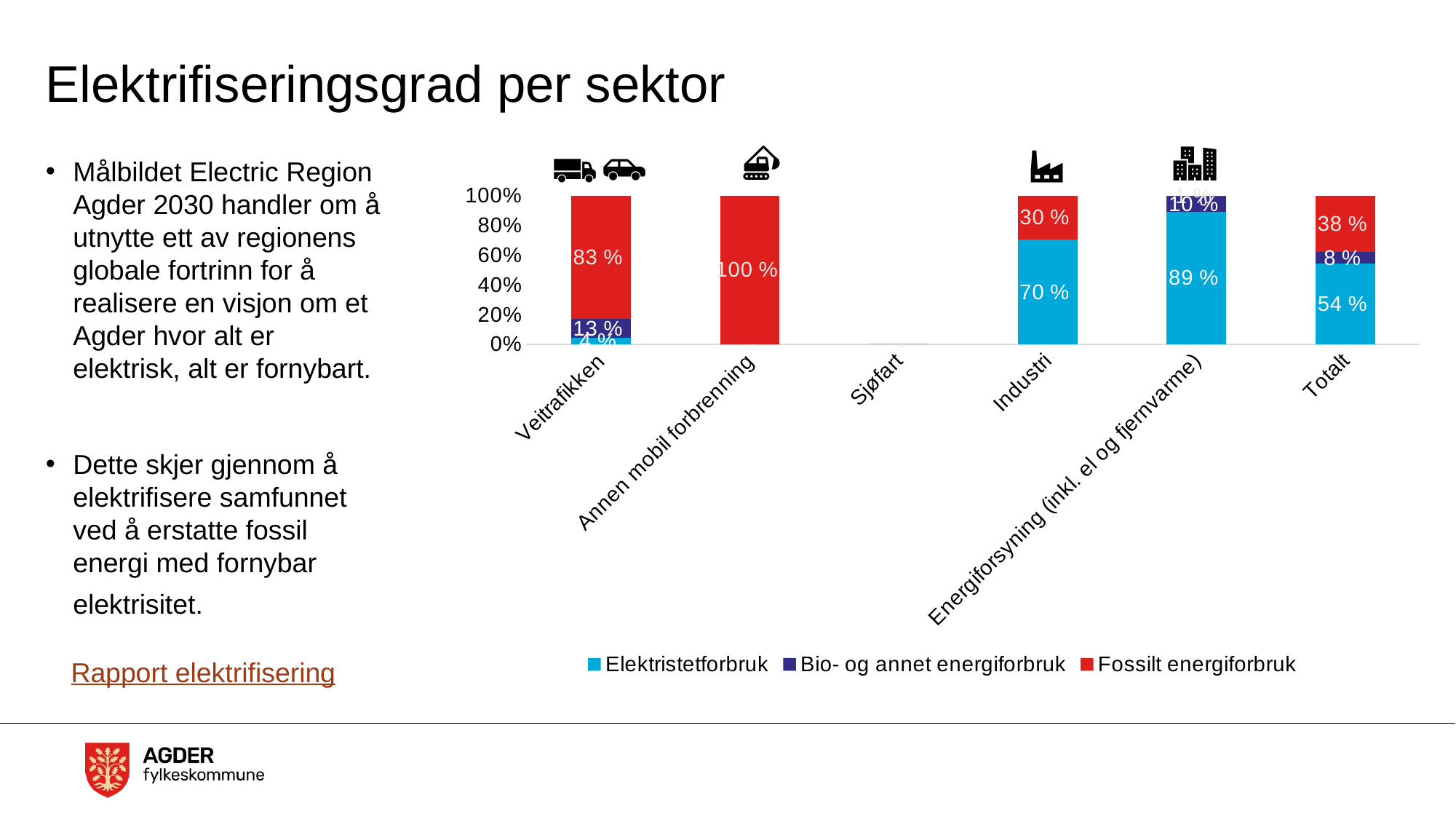
What is the Elektristetforbruk share for Industri? 70 % What is the Bio- og annet energiforbruk share for Totalt? 8 % Which category has the highest Elektristetforbruk share? Energiforsyning (inkl. el og fjernvarme) Which category has the highest Fossilt energiforbruk share? Annen mobil forbrenning What is the Fossilt energiforbruk share for Veitrafikken? 83 % What is the Elektristetforbruk share for Energiforsyning (inkl. el og fjernvarme)? 89 % How many sector categories are shown along the x axis of the chart? 6 What is the difference between the Fossilt energiforbruk share for Totalt and for Industri? 8 % Which has the larger Bio- og annet energiforbruk share, Veitrafikken or Energiforsyning (inkl. el og fjernvarme)? Veitrafikken How many series does the chart legend list? 3 What kind of chart is shown on the slide? Stacked bar chart What colour represents Fossilt energiforbruk in the chart? Red